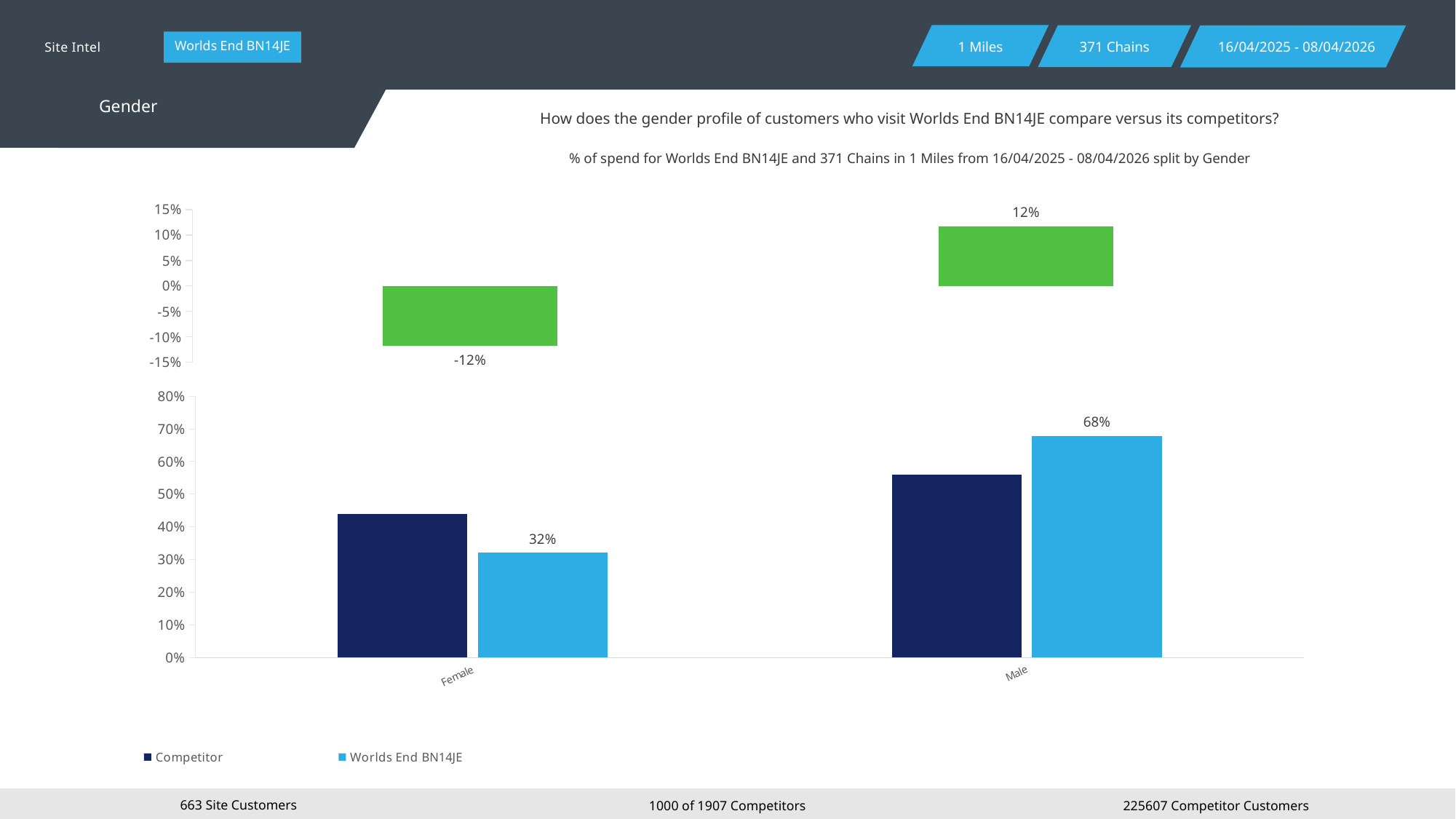
On the bottom chart, for Female, which is larger: the Competitor value or the Worlds End BN14JE value? Competitor On the bottom chart, for Male, which is larger: the Competitor value or the Worlds End BN14JE value? Worlds End BN14JE On the bottom chart, is the Competitor value for Female greater or less than 40%? greater On the bottom chart, what is the difference between the Worlds End BN14JE values for Male and Female? 36% On the top chart, what is the value shown for Female? -12% On the bottom chart, what is the value for Worlds End BN14JE for Female? 32% On the top chart, what is the value shown for Male? 12% What kind of chart is the bottom chart? Bar chart How many series does the legend of the bottom chart list? 2 On the bottom chart, is the Competitor value for Male greater or less than 60%? less On the bottom chart, which category has the higher value for Worlds End BN14JE? Male On the bottom chart, what is the value for Worlds End BN14JE for Male? 68%